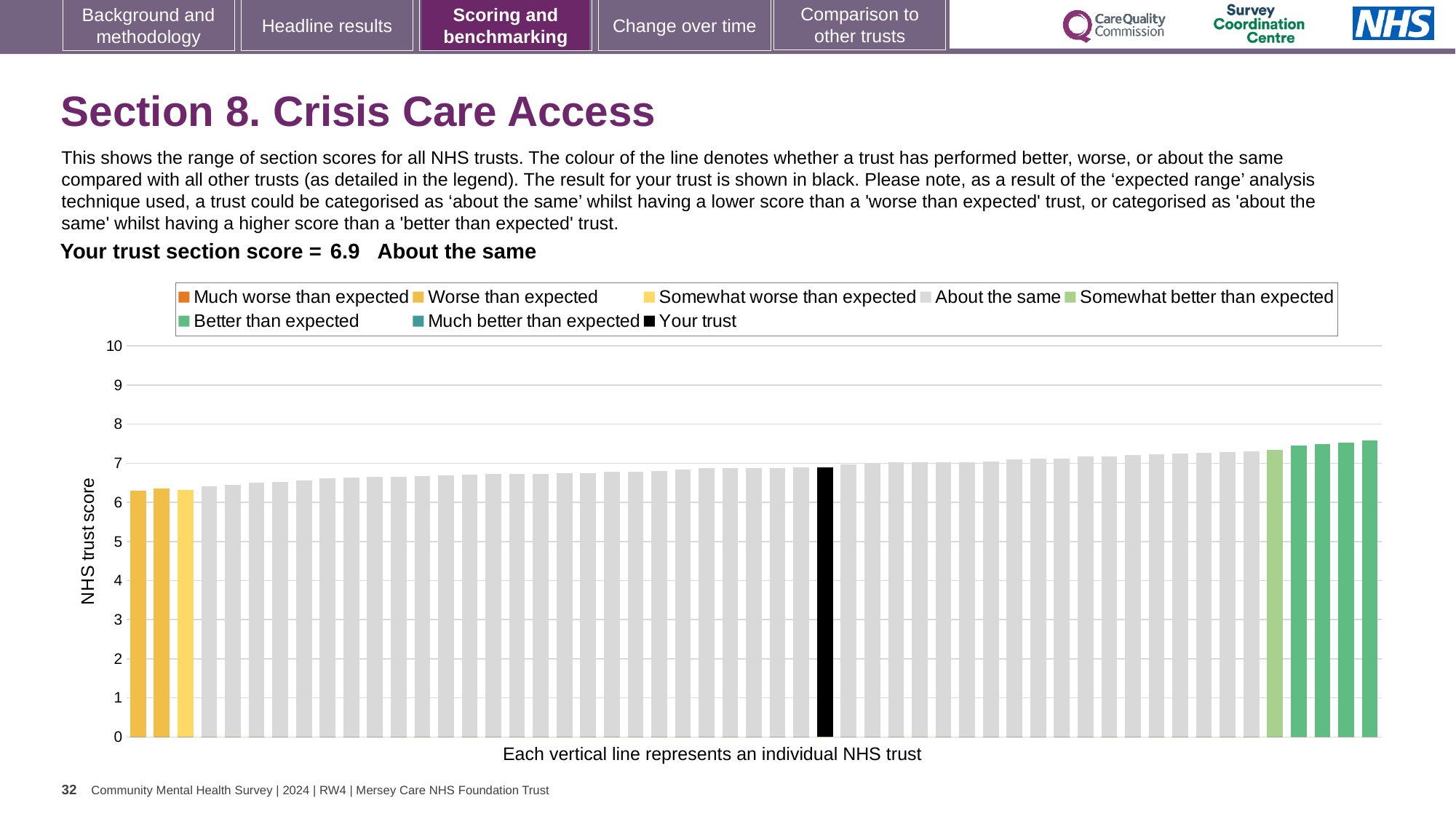
How many entries does the chart legend list? 8 How many bars are coloured as 'Worse than expected' (yellow)? 2 Is the value of the highest bar in the chart greater or less than 8? less How many bars are coloured as 'Better than expected' (green)? 4 Do the bar values rise or fall moving from left to right along the x axis? rise Is the value for your trust (the black bar) greater or less than 5? greater Is the value of the lowest bar in the chart greater or less than 6? greater What is the label on the vertical axis of the chart? NHS trust score What is the section score for your trust shown on the slide? 6.9 Which performance category is your trust placed in for Crisis Care Access? About the same Which is larger: the rightmost bar or the black 'Your trust' bar? the rightmost bar What kind of chart is shown on the slide? bar chart